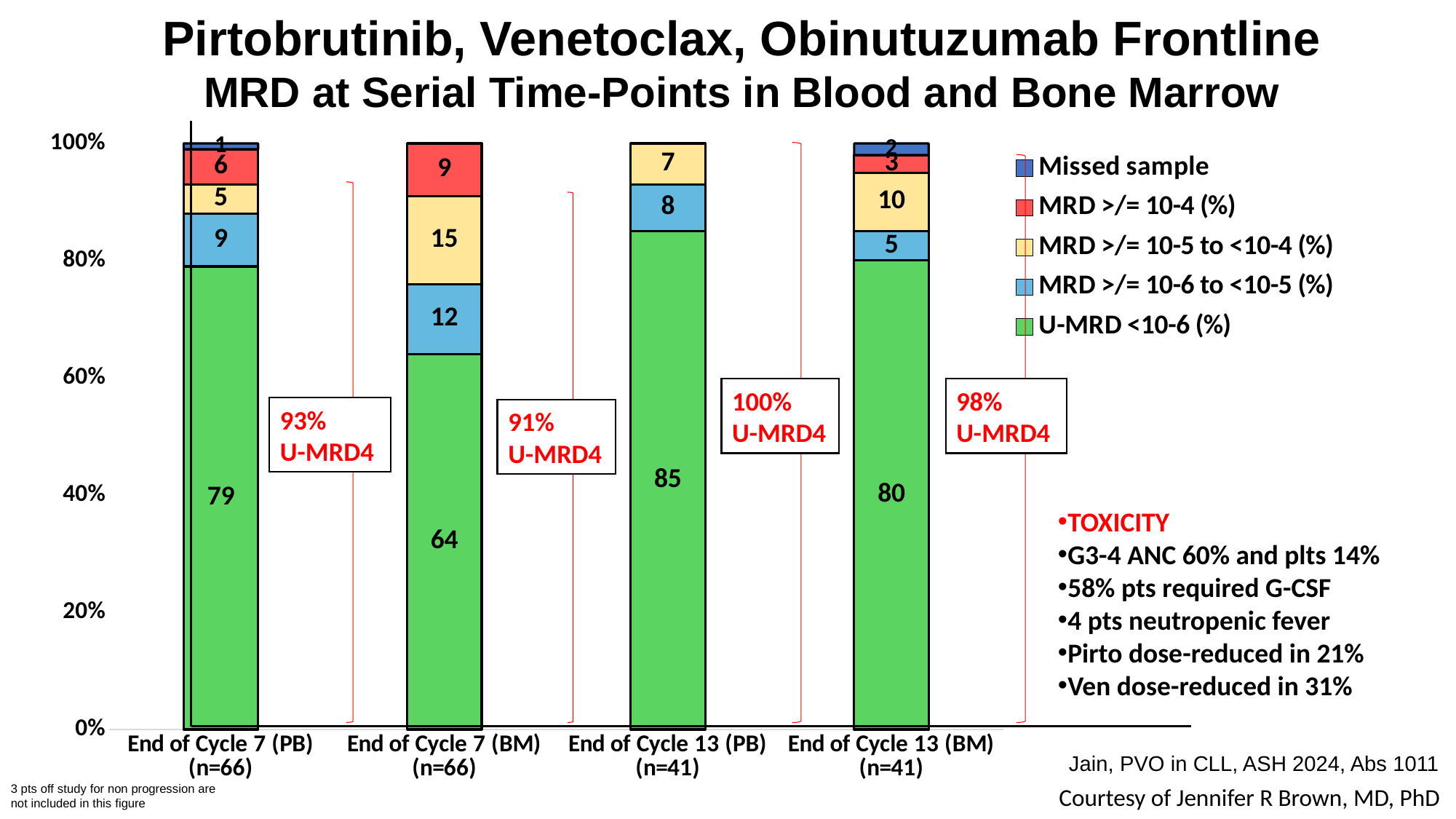
What is the U-MRD <10-6 (%) value for End of Cycle 7 (PB)? 79 Which time-point has the lowest U-MRD <10-6 (%) value? End of Cycle 7 (BM) What is the Missed sample value for End of Cycle 13 (BM)? 2 What is the difference between the U-MRD <10-6 (%) values for End of Cycle 13 (PB) and End of Cycle 7 (BM)? 21 How many series does the legend list? 5 How many time-point categories are plotted on the x axis? 4 Which time-point has the highest U-MRD <10-6 (%) value? End of Cycle 13 (PB) What is the MRD >/= 10-5 to <10-4 (%) value for End of Cycle 7 (BM)? 15 What U-MRD4 percentage is annotated for End of Cycle 13 (PB)? 100% U-MRD4 What kind of chart is shown on the slide? Stacked bar chart Which is larger: the MRD >/= 10-4 (%) value for End of Cycle 7 (BM) or for End of Cycle 13 (BM)? End of Cycle 7 (BM) What is the MRD >/= 10-6 to <10-5 (%) value for End of Cycle 13 (PB)? 8